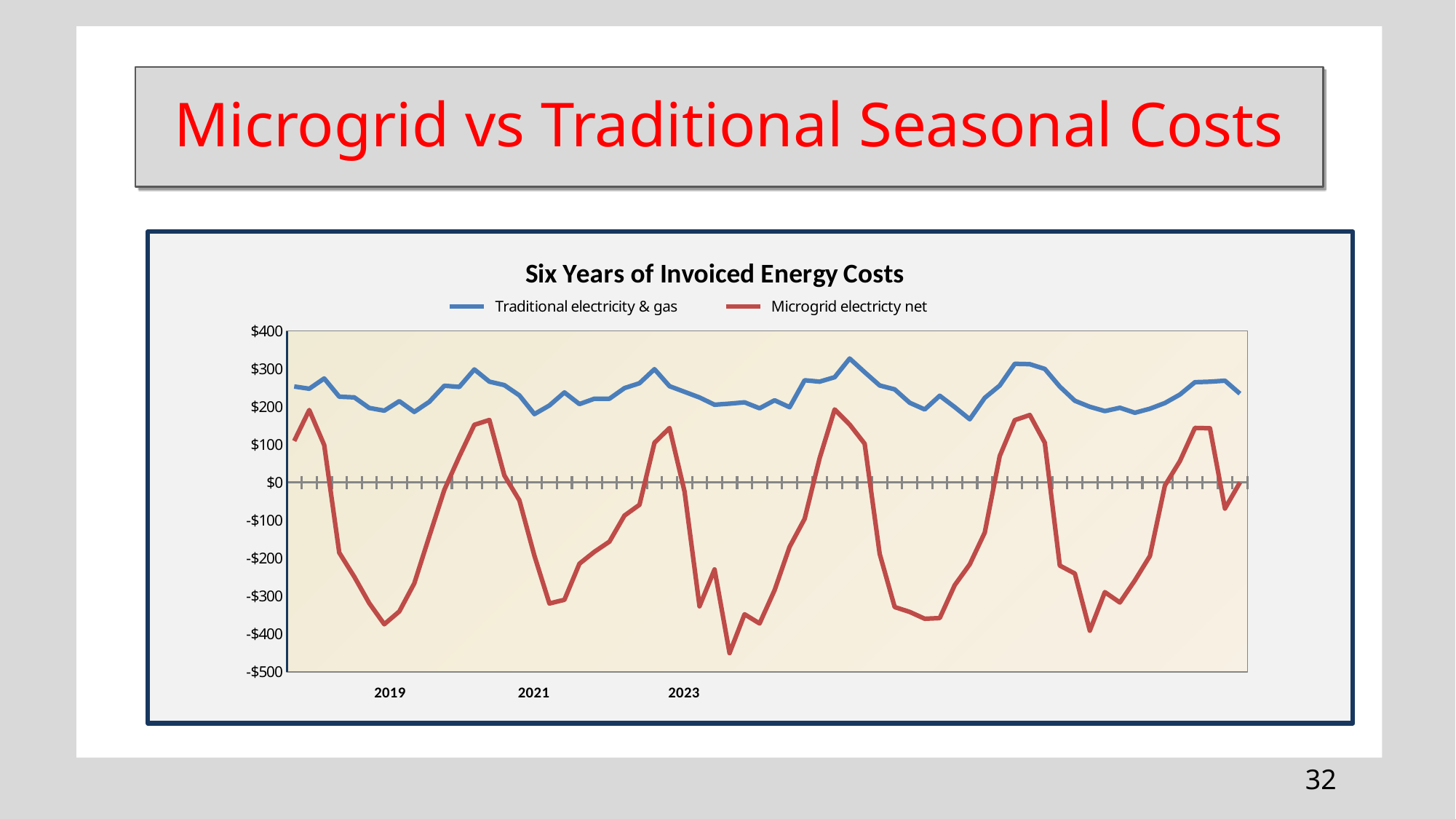
Is the lowest value of the Microgrid electricty net series greater or less than -$400? less What kind of chart is shown on the slide? line chart Is the lowest value of the Traditional electricity & gas series greater or less than $100? greater Which series is drawn in red in the chart? Microgrid electricty net Does the Traditional electricity & gas series ever fall below $0 on the chart? No How many series does the chart legend list? 2 How many year labels are shown on the x axis of the chart? 3 What is the title of the chart? Six Years of Invoiced Energy Costs Which series reaches the lowest value on the chart, Traditional electricity & gas or Microgrid electricty net? Microgrid electricty net Which series has the higher value at the start of the chart, Traditional electricity & gas or Microgrid electricty net? Traditional electricity & gas